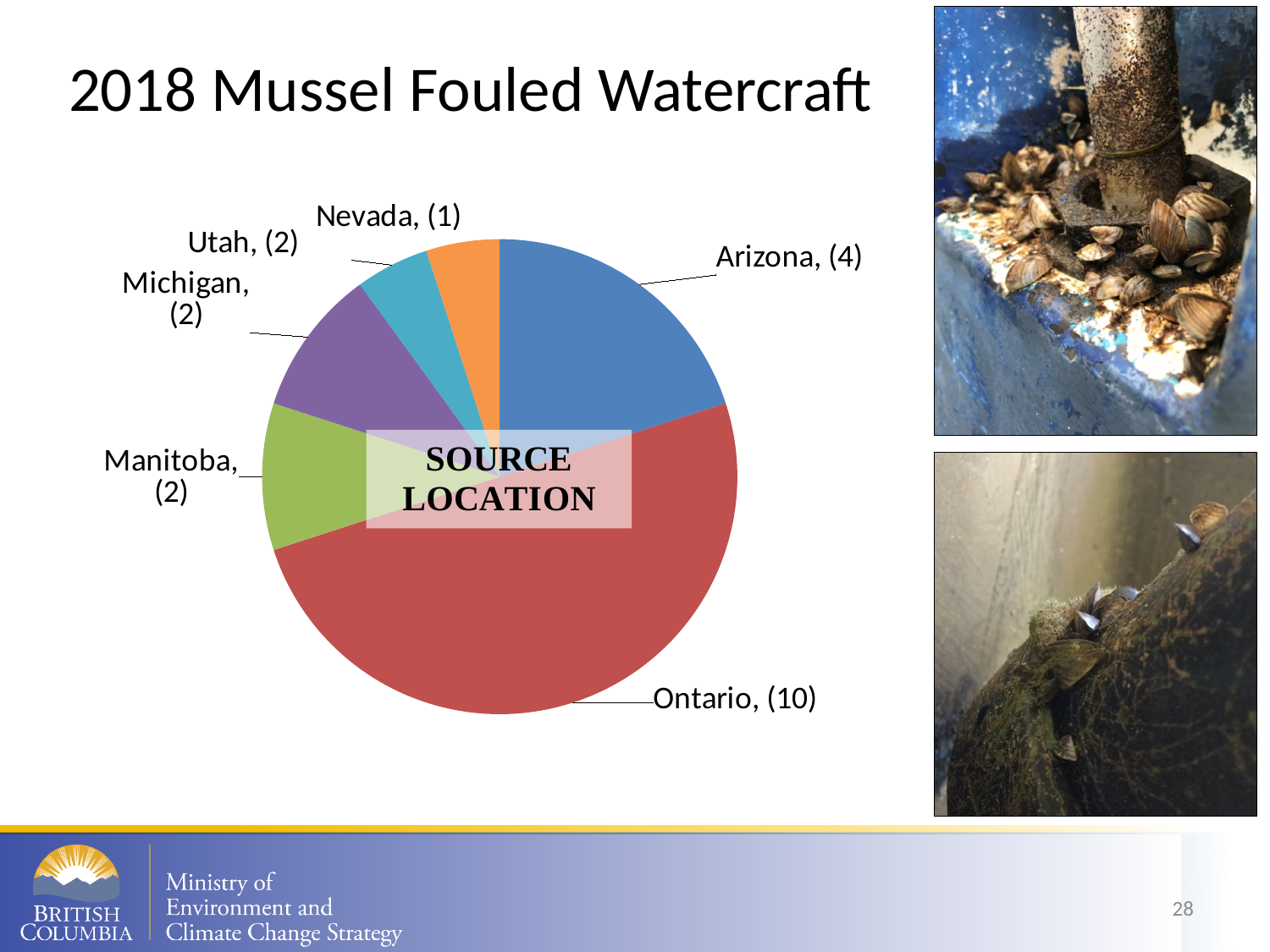
Which has more watercraft, Arizona or Utah? Arizona How many watercraft came from Manitoba? 2 How many watercraft came from Arizona? 4 How many watercraft came from Nevada? 1 How many more watercraft came from Ontario than from Arizona? 6 What text is shown in the centre of the pie chart? SOURCE LOCATION Which source location has the largest slice of the pie? Ontario How many source locations are shown in the pie chart? 6 What type of chart is shown on the slide? pie chart What is the total number of watercraft across all source locations in the pie chart? 21 How many watercraft came from Ontario? 10